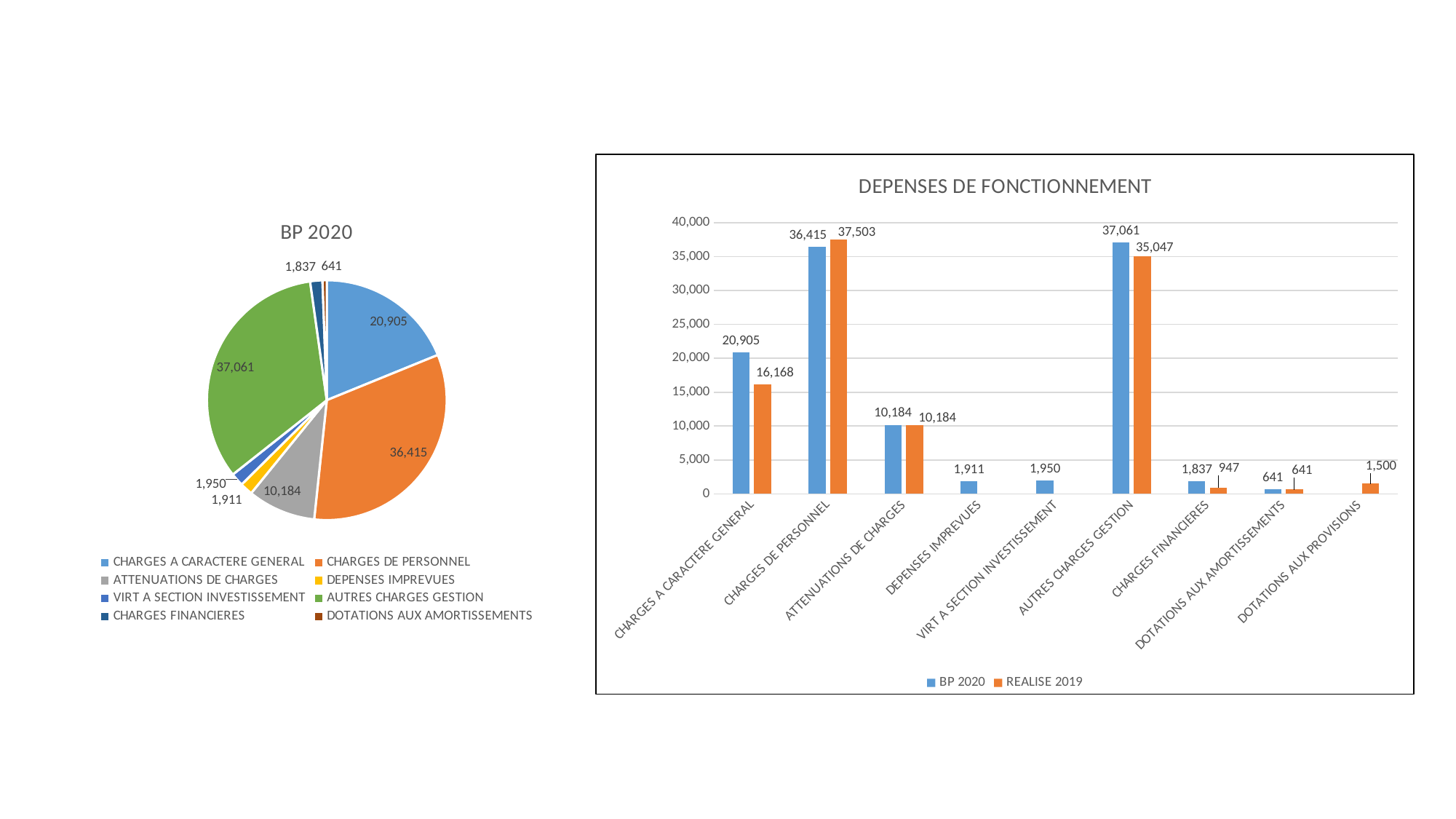
In the BP 2020 pie chart, which category has the smallest slice? DOTATIONS AUX AMORTISSEMENTS How many series does the legend of the DEPENSES DE FONCTIONNEMENT bar chart list? 2 In the DEPENSES DE FONCTIONNEMENT bar chart, what is the difference between the REALISE 2019 and BP 2020 values for CHARGES DE PERSONNEL? 1,088 In the DEPENSES DE FONCTIONNEMENT bar chart, what is the REALISE 2019 value for CHARGES A CARACTERE GENERAL? 16,168 What kind of chart is the chart titled BP 2020 on the left of the slide? Pie chart In the BP 2020 pie chart, what is the value for CHARGES DE PERSONNEL? 36,415 In the DEPENSES DE FONCTIONNEMENT bar chart, which series has the larger value for AUTRES CHARGES GESTION, BP 2020 or REALISE 2019? BP 2020 In the BP 2020 pie chart, which category has the largest slice? AUTRES CHARGES GESTION How many categories are shown on the x axis of the DEPENSES DE FONCTIONNEMENT bar chart? 9 In the DEPENSES DE FONCTIONNEMENT bar chart, what is the REALISE 2019 value for DOTATIONS AUX PROVISIONS? 1,500 In the DEPENSES DE FONCTIONNEMENT bar chart, what is the difference between the BP 2020 and REALISE 2019 values for CHARGES FINANCIERES? 890 How many categories does the legend of the BP 2020 pie chart list? 8